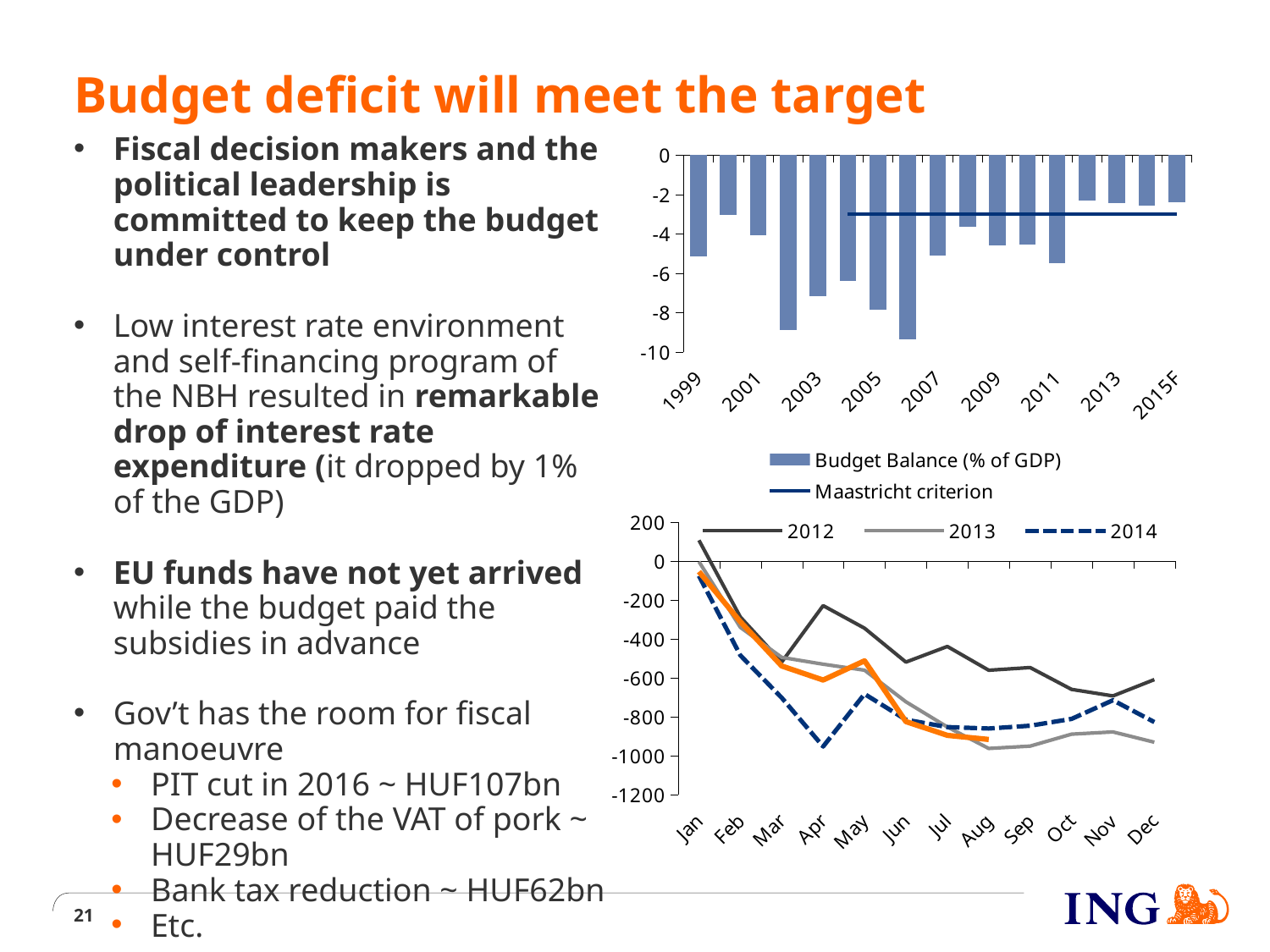
What kind of chart is the bottom chart on the slide? line chart In the top chart, which year has the lowest (most negative) budget balance? 2006 In the top chart, is the budget balance for 2012 greater or less than -4? greater In the bottom chart, how many months are shown on the x axis? 12 In the bottom chart, is the 2013 value for December greater or less than -800? less In the top chart, is the budget balance for 2006 greater or less than -8? less In the top chart, what is the name of the series drawn as a horizontal line? Maastricht criterion In the top chart, how many series does the legend list? 2 What kind of chart is the top chart on the slide? bar chart In the bottom chart, how many series does the legend list? 3 In the bottom chart, which is larger in April, the 2012 value or the 2014 value? 2012